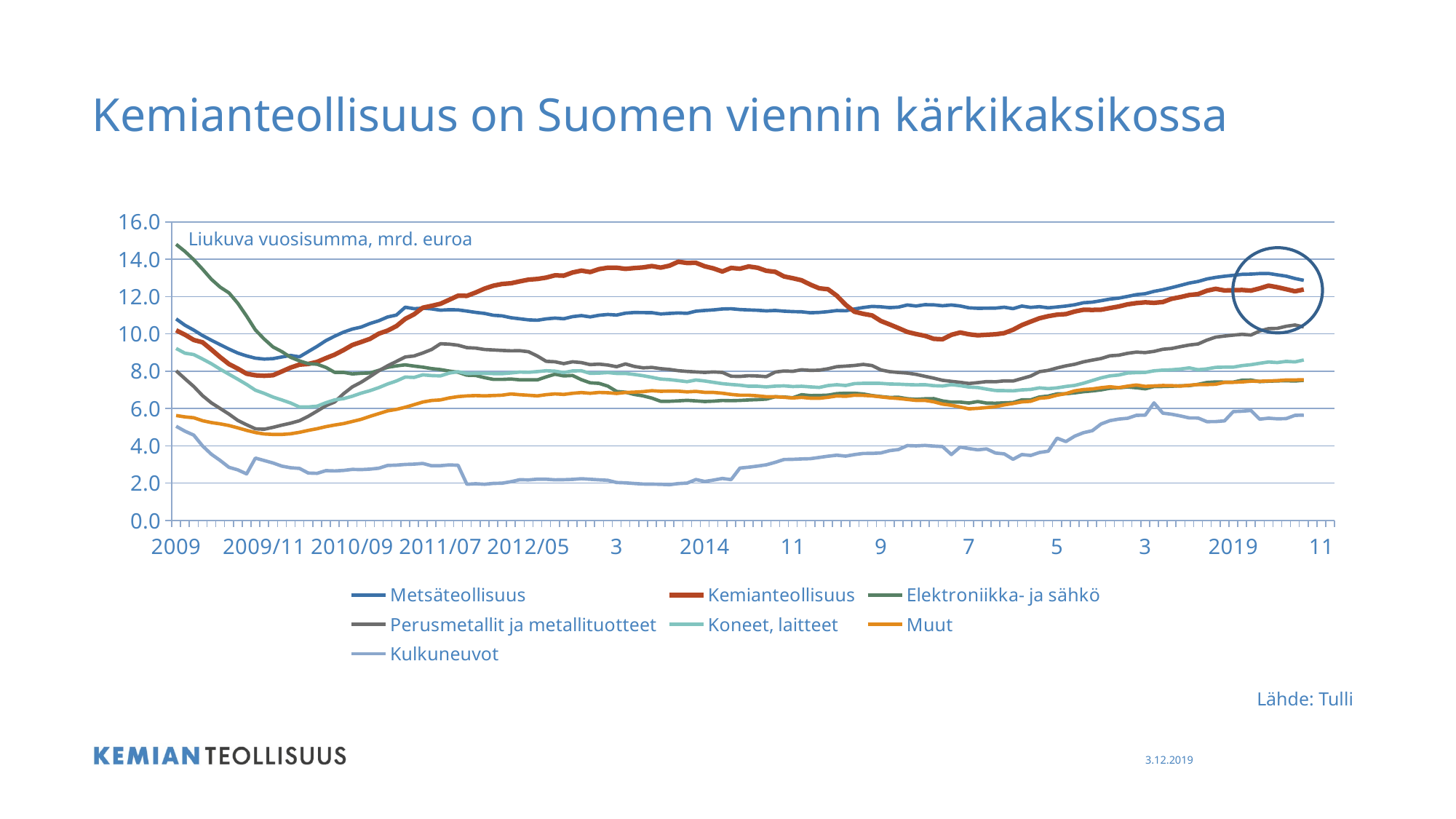
What unit description is printed inside the chart area? Liukuva vuosisumma, mrd. euroa Which series has the lowest value at the end of the chart (11, 2019)? Kulkuneuvot Is the value for Metsäteollisuus at 2009/11 greater or less than 10.0? less Is the value for Kemianteollisuus at 2014 greater or less than 12.0? greater Does the Kulkuneuvot line rise or fall between 2014 and 2019? rise What type of chart is shown on the slide? line chart At 2019, which is larger: Metsäteollisuus or Kemianteollisuus? Metsäteollisuus Does the Elektroniikka- ja sähkö line rise or fall between 2009 and 2009/11? fall Which series has the highest value at the start of the chart (2009)? Elektroniikka- ja sähkö Is the value for Kulkuneuvot at 2014 greater or less than 4.0? less How many series does the legend list? 7 Which series has the lowest value at the start of the chart (2009)? Kulkuneuvot